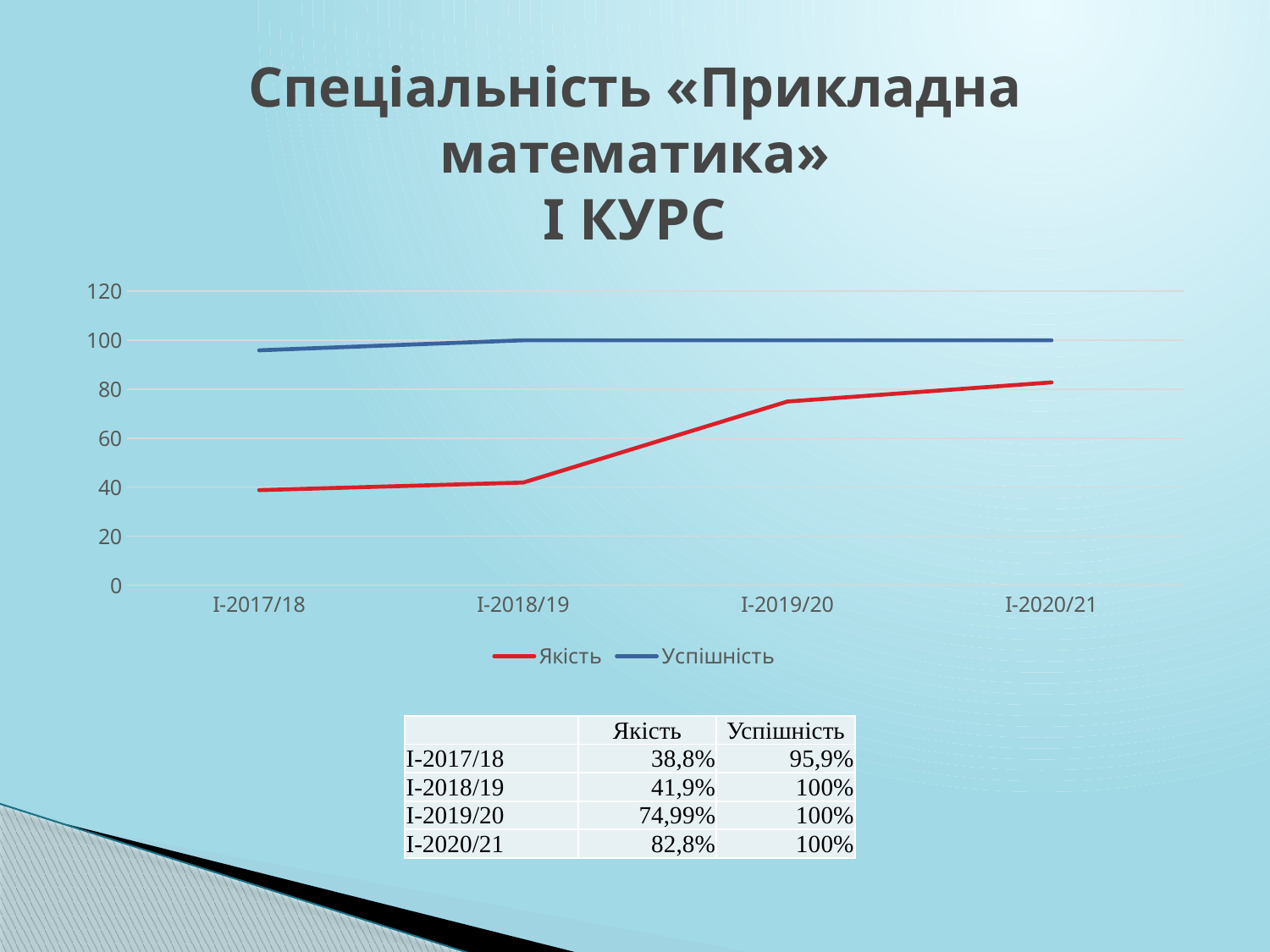
What is the value of Якість for I-2020/21? 82,8% What is the value of Успішність for I-2017/18? 95,9% In which period is Якість the lowest? I-2017/18 In which period is Якість the highest? I-2020/21 Does the Якість line rise or fall from I-2017/18 to I-2020/21? rise Which is larger for I-2018/19, Якість or Успішність? Успішність What is the value of Якість for I-2019/20? 74,99% How many points are plotted along the x axis for each series? 4 Which series is drawn with the red line? Якість What kind of chart is shown on the slide? line chart What is the value of Якість for I-2017/18? 38,8% How many series does the chart legend list? 2